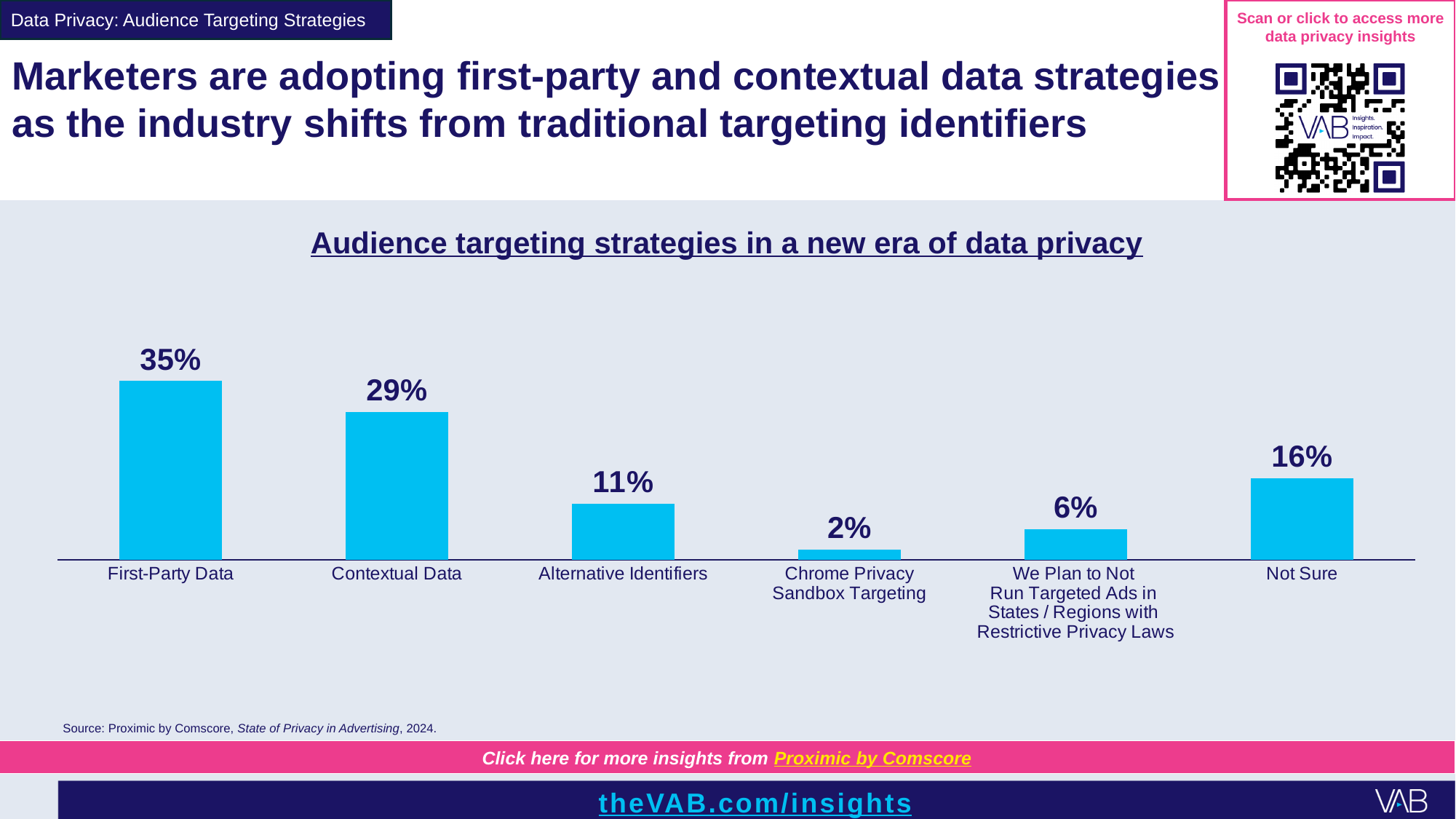
What is the value shown for Contextual Data? 29% What percentage of respondents answered Not Sure? 16% Which is larger: the value for Alternative Identifiers or the value for Not Sure? Not Sure What is the difference between the values for Not Sure and Alternative Identifiers? 5% How many categories are shown on the chart? 6 What is the difference between the values for First-Party Data and Contextual Data? 6% Which audience targeting strategy has the highest value? First-Party Data Which category has the lowest value? Chrome Privacy Sandbox Targeting What percentage of marketers use First-Party Data as an audience targeting strategy? 35% What is the title of the chart? Audience targeting strategies in a new era of data privacy What kind of chart is shown on the slide? Bar chart What is the value shown for Chrome Privacy Sandbox Targeting? 2%